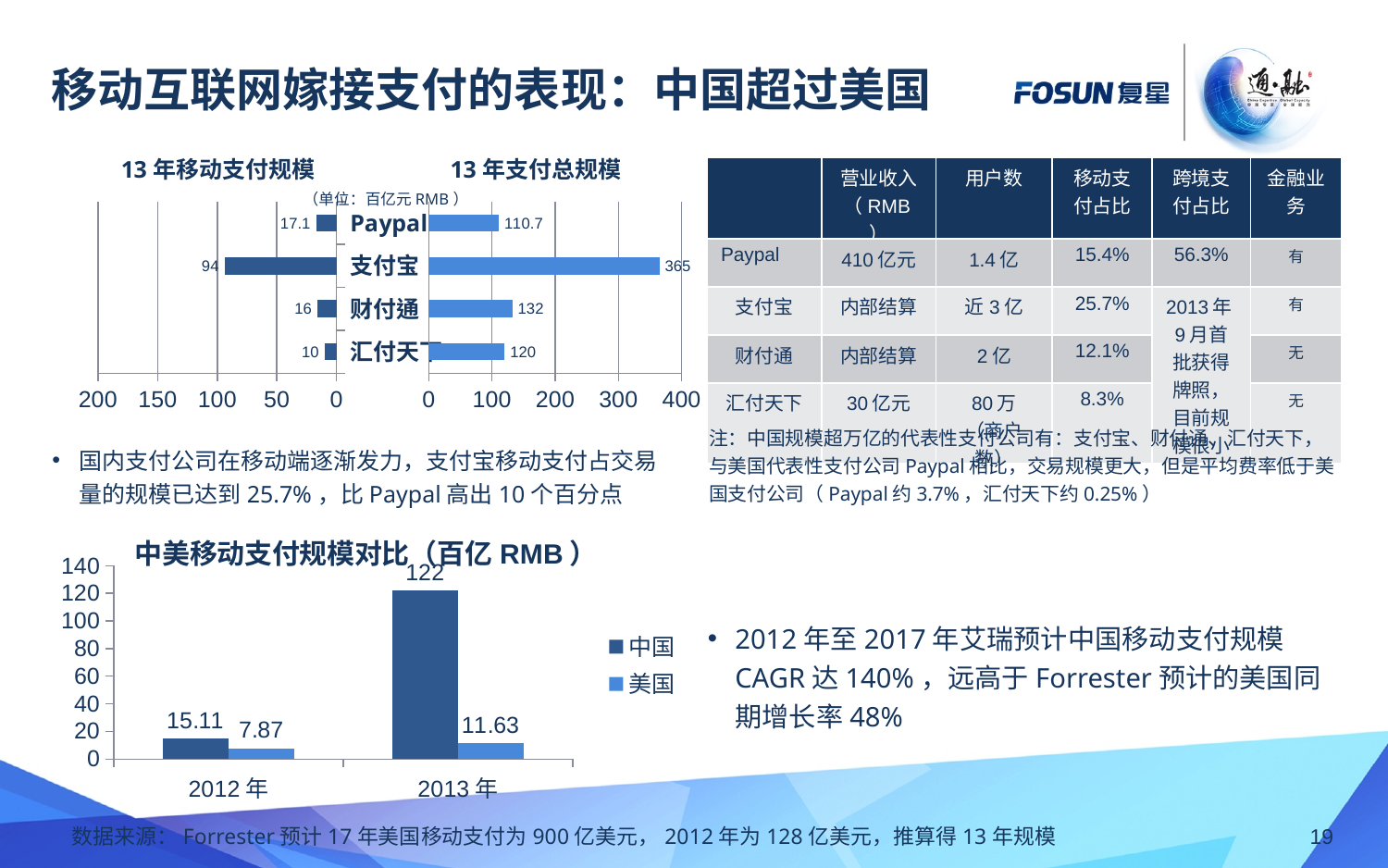
In the chart titled 13年移动支付规模, which category has the lowest value? 汇付天下 In the chart titled 中美移动支付规模对比（百亿RMB）, how many series does the legend list? 2 In the chart titled 13年支付总规模, what is the difference between the values for 支付宝 and Paypal? 254.3 In the chart titled 13年移动支付规模, what is the value for 支付宝? 94 In the chart titled 中美移动支付规模对比（百亿RMB）, what is the value for 美国 in 2012年? 7.87 What kind of chart is the chart titled 中美移动支付规模对比（百亿RMB）? bar chart In the chart titled 中美移动支付规模对比（百亿RMB）, what is the difference between 中国 and 美国 in 2013年? 110.37 In the chart titled 中美移动支付规模对比（百亿RMB）, does the value for 中国 rise or fall from 2012年 to 2013年? rise In the chart titled 13年支付总规模, which category has the highest value? 支付宝 In the chart titled 中美移动支付规模对比（百亿RMB）, what is the value for 中国 in 2013年? 122 In the chart titled 13年支付总规模, what is the value for 财付通? 132 In the chart titled 13年移动支付规模, which is larger, the value for Paypal or the value for 财付通? Paypal